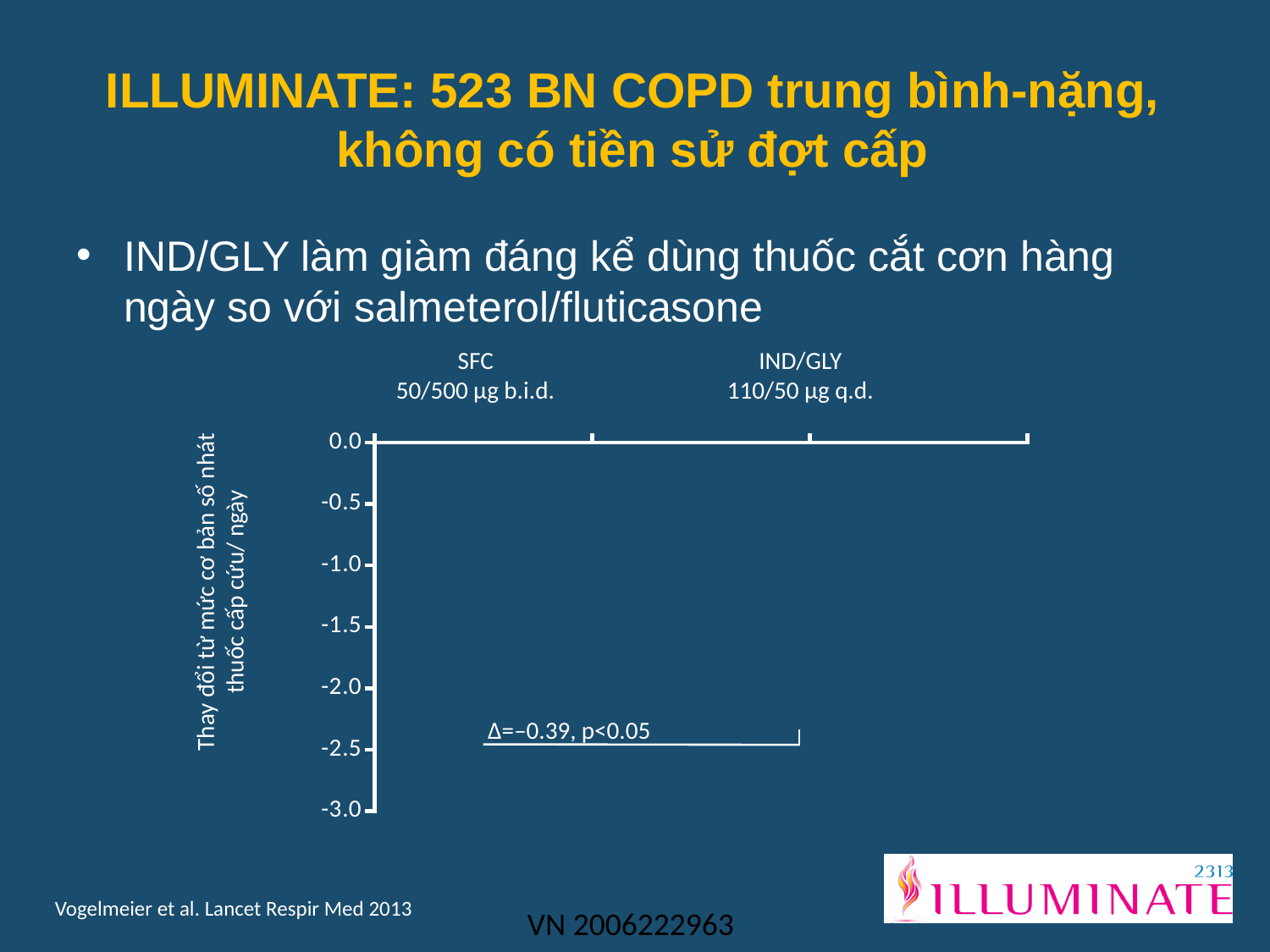
What is the difference (Δ) between the two treatment groups printed on the chart? −0.39 What is the lowest value shown on the chart's y axis? -3.0 What p-value is printed on the chart for the difference between the groups? p<0.05 How many treatment groups (categories) are shown on the chart's x axis? 2 What dose is shown for the IND/GLY group on the chart? 110/50 µg q.d. What dose is shown for the SFC group on the chart? 50/500 µg b.i.d.